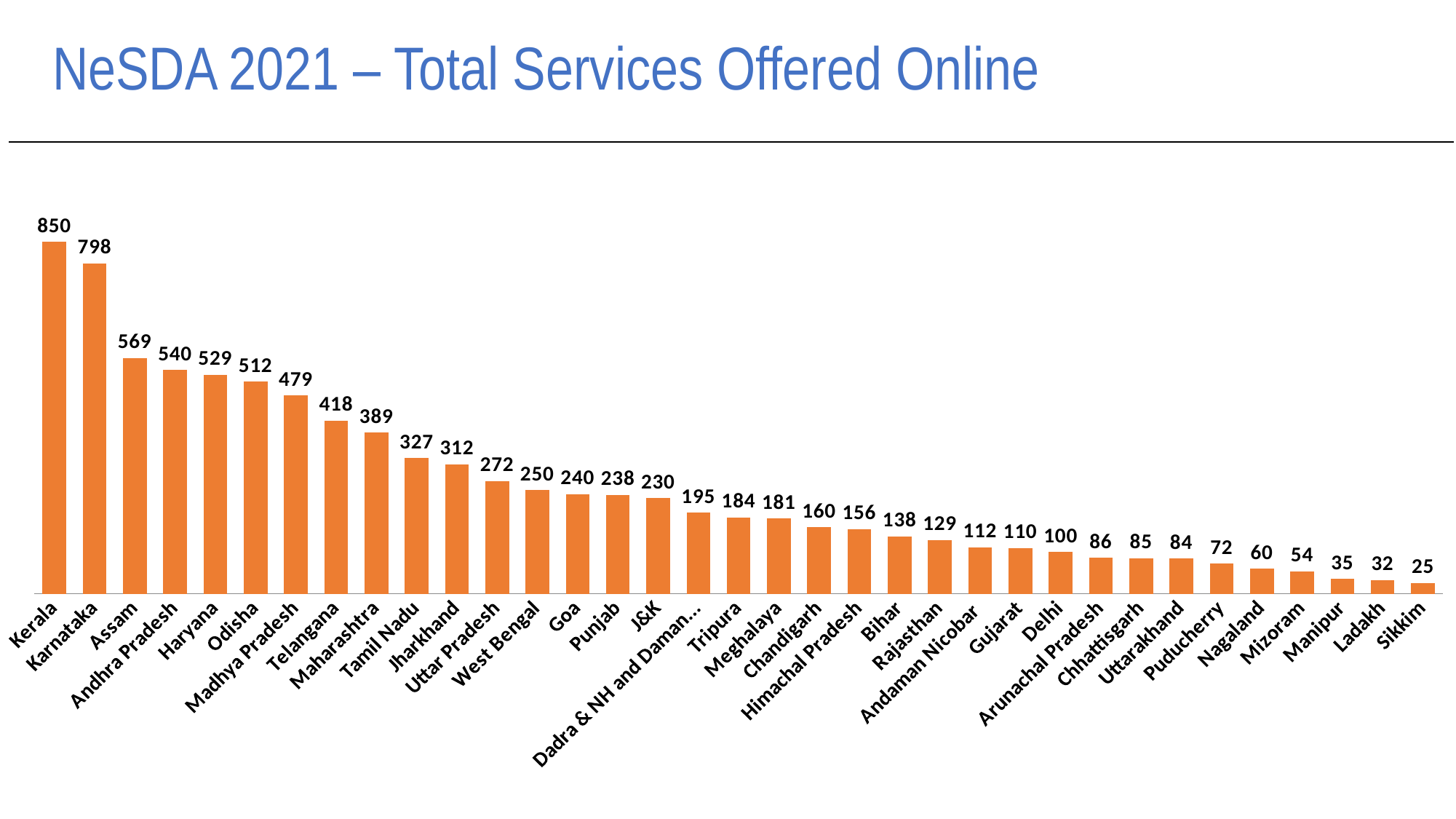
What is the value for Tamil Nadu? 327 What is the value for Gujarat? 110 How many states and territories are shown on the chart? 35 Which state or territory has the lowest value? Sikkim What is the difference between the values for Assam and Bihar? 431 Which has a larger value, Delhi or Puducherry? Delhi What is the value for Kerala? 850 Which has a larger value, Odisha or Telangana? Odisha Do the values rise or fall from left to right along the x axis? Fall What is the difference between the values for Kerala and Karnataka? 52 What kind of chart is shown on the slide? Bar chart Which state or territory has the highest value? Kerala